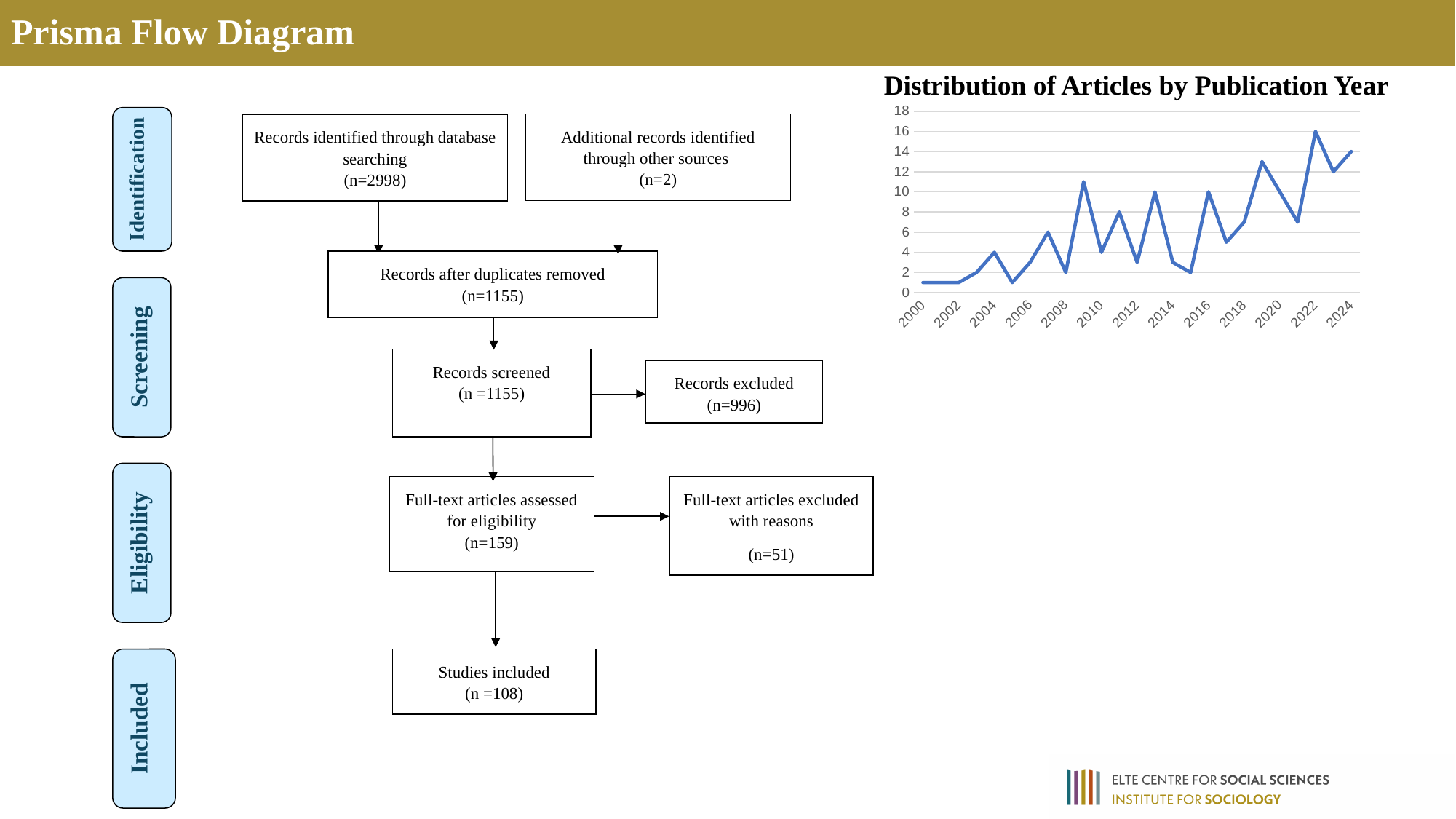
In the "Distribution of Articles by Publication Year" chart, which year has the highest number of articles? 2022 In the "Distribution of Articles by Publication Year" chart, which is larger, the value for 2002 or the value for 2020? 2020 In the "Distribution of Articles by Publication Year" chart, do the values generally rise or fall from 2000 to 2024? rise In the "Distribution of Articles by Publication Year" chart, what is the value for 2024? 14 In the "Distribution of Articles by Publication Year" chart, is the value for 2018 greater or less than 8? less In the "Distribution of Articles by Publication Year" chart, which is larger, the value for 2022 or the value for 2024? 2022 What kind of chart is "Distribution of Articles by Publication Year"? line chart In the "Distribution of Articles by Publication Year" chart, what is the value for 2022? 16 How many year labels are shown on the x axis of the "Distribution of Articles by Publication Year" chart? 13 In the "Distribution of Articles by Publication Year" chart, is the value for 2006 greater or less than 4? less In the "Distribution of Articles by Publication Year" chart, is the value for 2016 greater or less than 8? greater